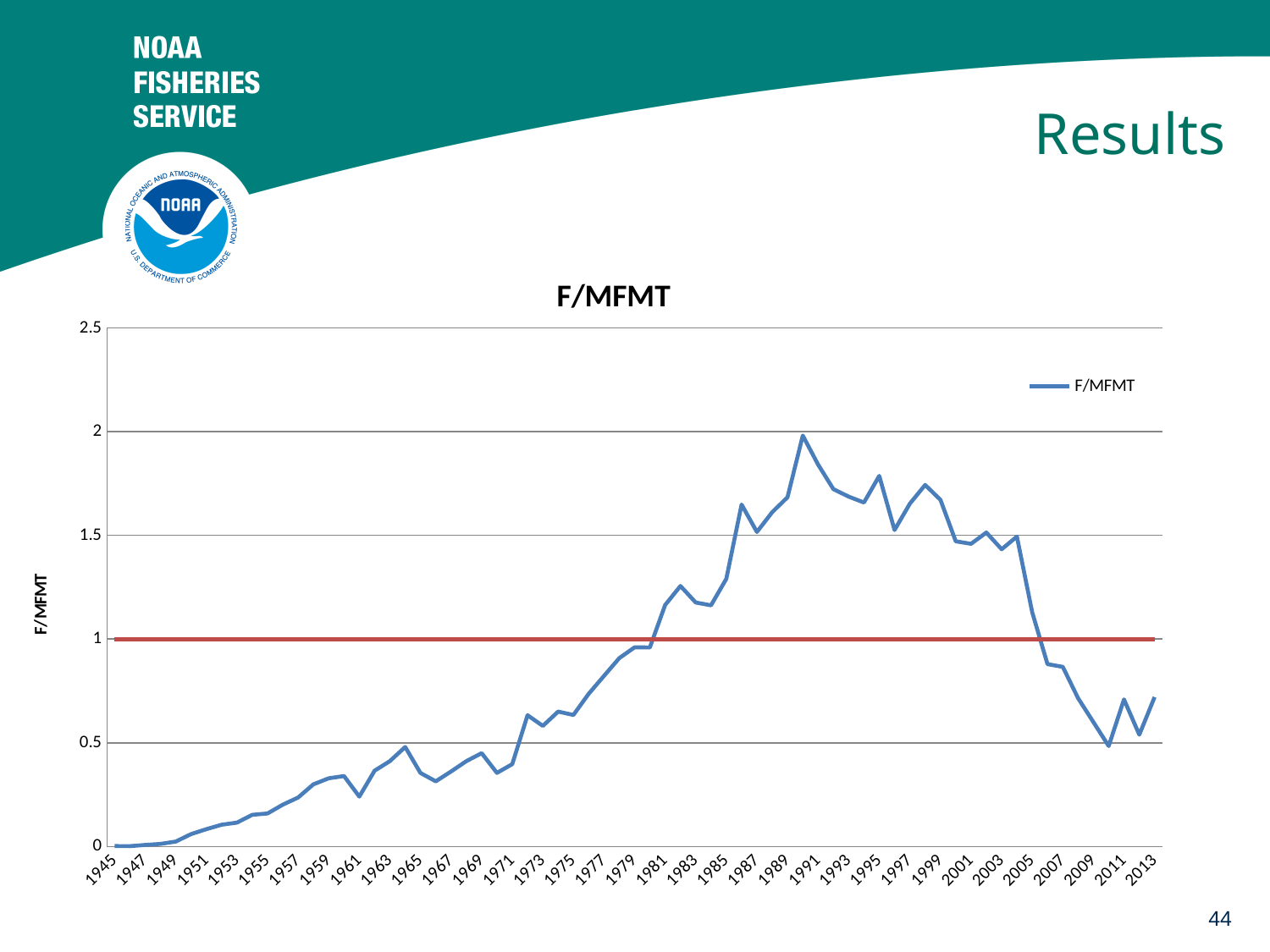
Does the F/MFMT line generally rise or fall between 1945 and 1991? rise Is the F/MFMT value for 1961 greater or less than 0.5? less Is the F/MFMT value for 1991 greater or less than 1.5? greater What is the title of the chart? F/MFMT Is the F/MFMT value for 2009 greater or less than 1? less In which year does the F/MFMT line reach its highest value? 1990 What kind of chart is shown on the slide? line chart Which year has the larger F/MFMT value, 1991 or 2013? 1991 At what value on the y axis is the red horizontal reference line drawn? 1 How many series does the legend list? 1